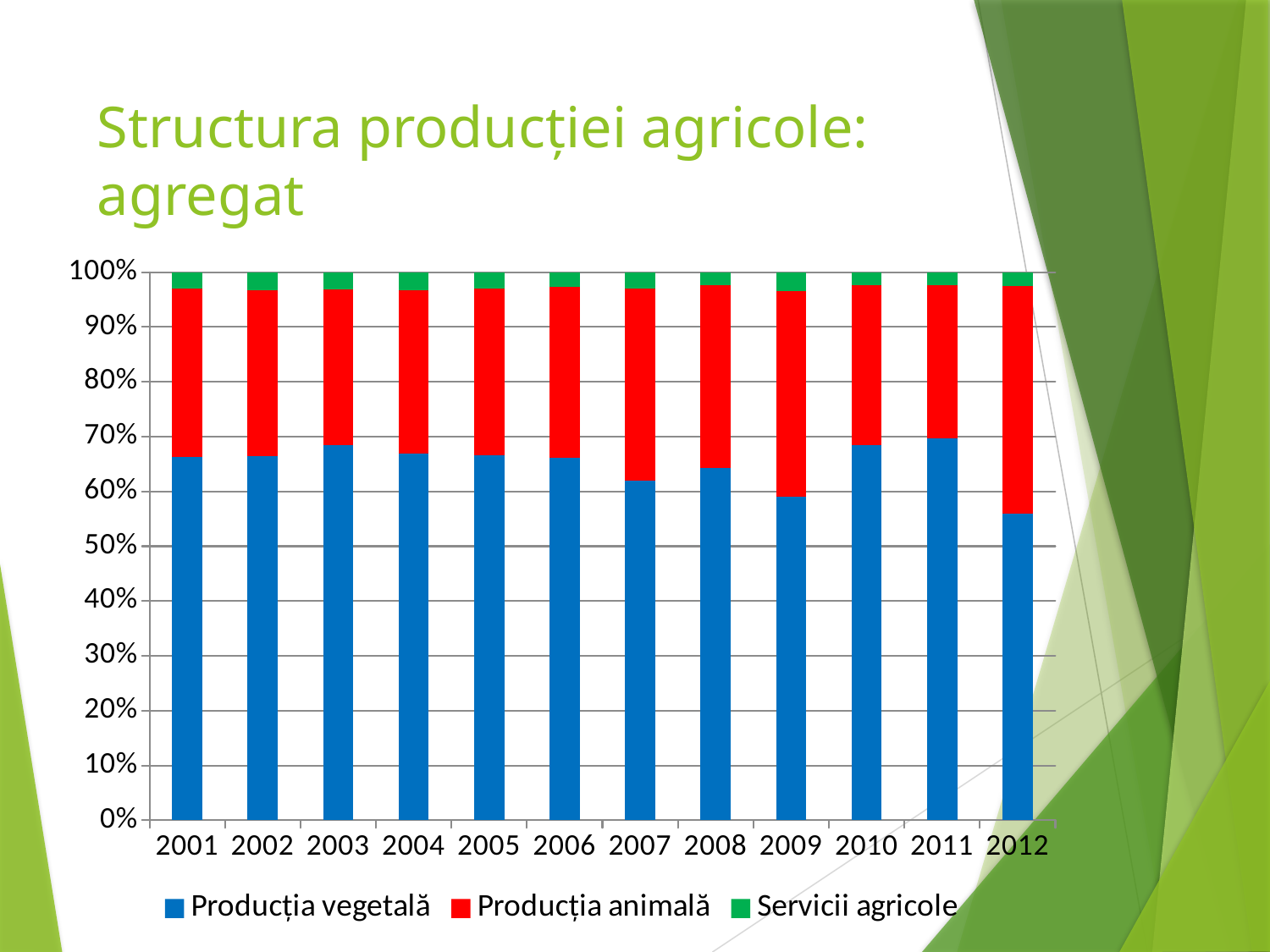
What kind of chart is shown on the slide? stacked bar chart In which year is the share of Producția vegetală the lowest? 2012 Which year has a larger share of Producția vegetală, 2003 or 2009? 2003 How many years are shown on the x axis of the chart? 12 Is the share of Producția vegetală in 2007 greater or less than 50%? greater Which series is shown in green in the chart? Servicii agricole What is the total of the stacked bar for 2012? 100% How many series does the chart legend list? 3 Which year has a larger share of Producția vegetală, 2011 or 2012? 2011 Is the share of Producția vegetală in 2012 greater or less than 60%? less Is the share of Producția vegetală in 2011 greater or less than 60%? greater What is the title of the slide containing the chart? Structura producției agricole: agregat